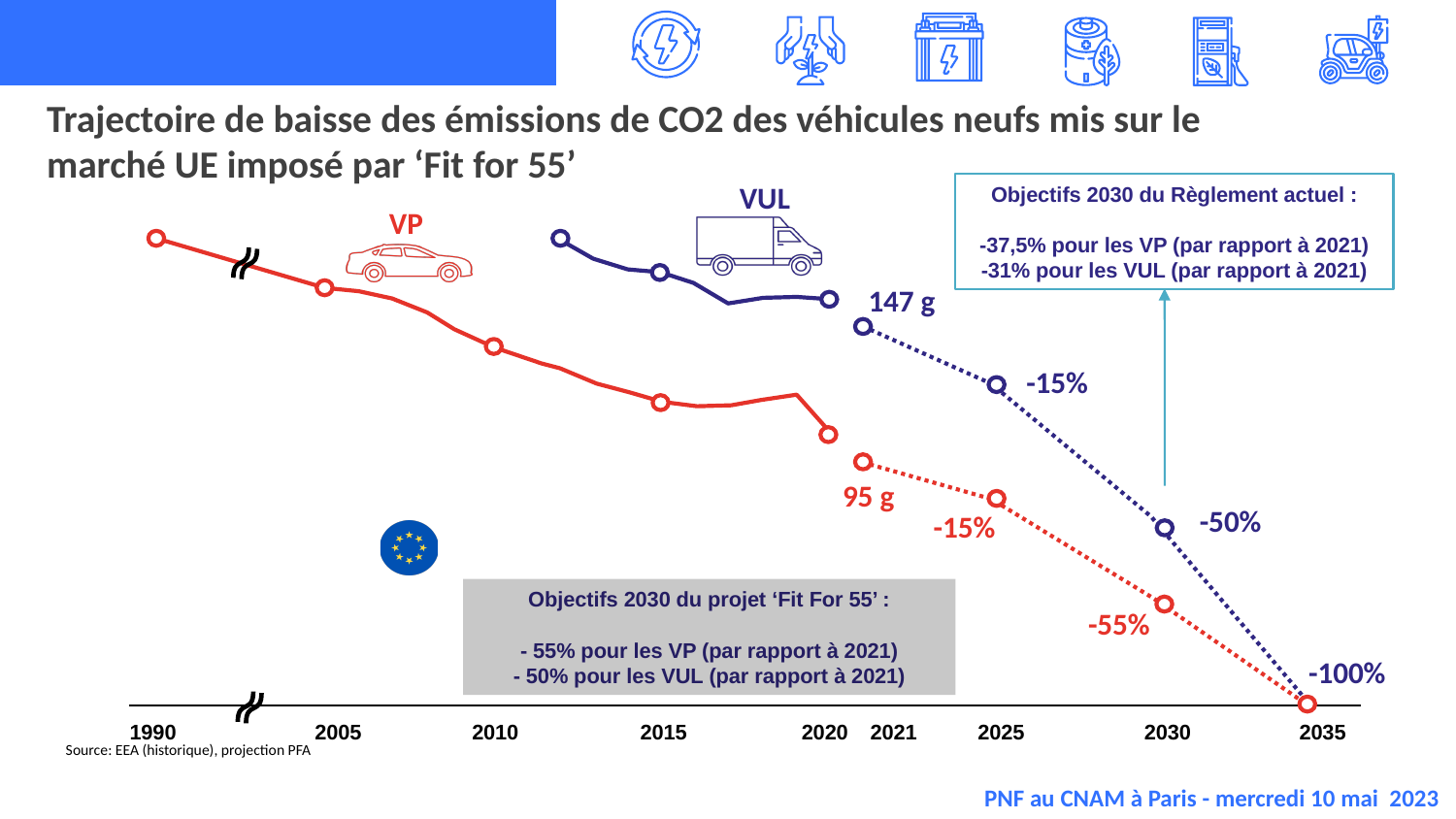
What is the CO2 emission value shown for VUL in 2021? 147 g What reduction is shown at 2035 on the chart? -100% What is the difference between the VUL and VP emission values in 2021? 52 g What reduction is shown for VUL in 2030 on the chart? -50% Which series has the higher emission value in 2021, VP or VUL? VUL What kind of chart is shown on the slide? line chart What reduction is shown for both VP and VUL in 2025? -15% What colour is the VP line on the chart? red What reduction is shown for VP in 2030 on the chart? -55% Does the VP line rise or fall from 1990 to 2035? fall What is the CO2 emission value shown for VP in 2021? 95 g How many series are plotted on the chart? 2